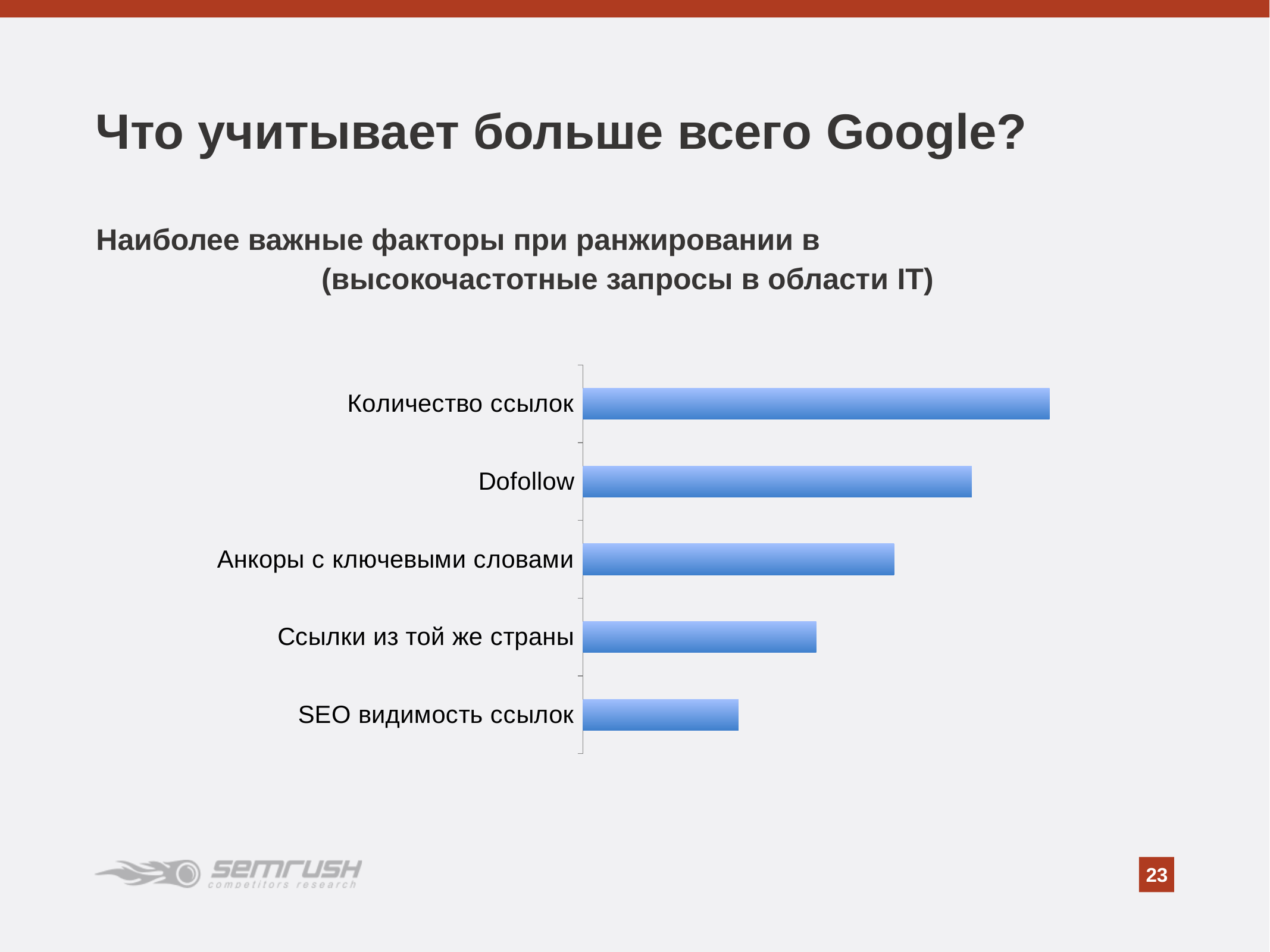
Which category is listed second from the top in the chart? Dofollow Which category has the shortest bar? SEO видимость ссылок Do the bar lengths increase or decrease going from the top category to the bottom category? decrease How many categories does the chart show? 5 Which category has the longest bar? Количество ссылок What is the title of the slide containing the chart? Что учитывает больше всего Google? Which has the larger value, Dofollow or Анкоры с ключевыми словами? Dofollow Which has the larger value, Ссылки из той же страны or SEO видимость ссылок? Ссылки из той же страны Which has the larger value, Анкоры с ключевыми словами or Ссылки из той же страны? Анкоры с ключевыми словами What kind of chart is shown on the slide? bar chart